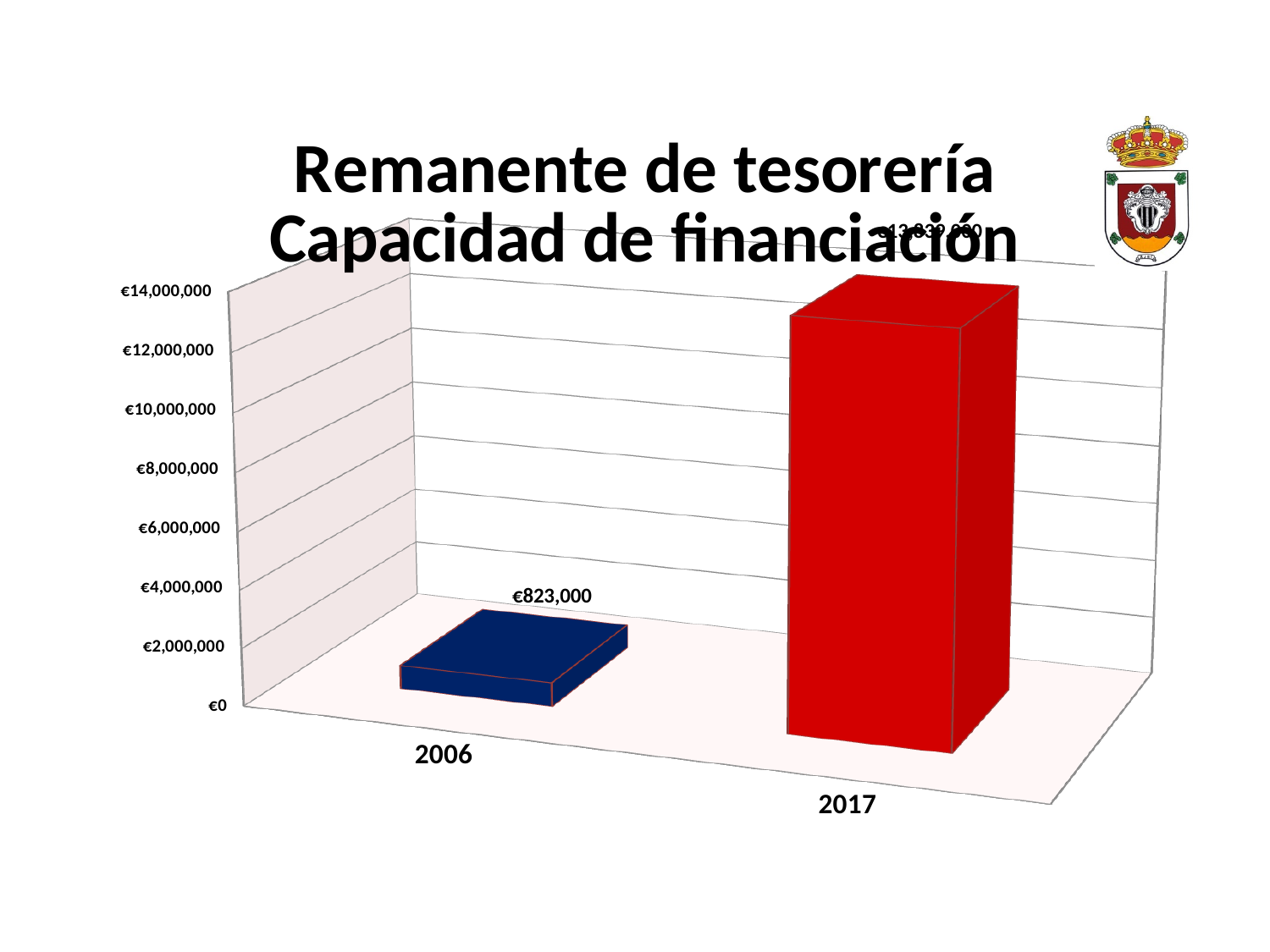
Is the value for 2017 greater or less than €10,000,000? greater Is the value for 2006 greater or less than €2,000,000? less Do the values rise or fall from 2006 to 2017? rise What is the value for 2006? €823,000 What is the title of the chart? Remanente de tesorería Capacidad de financiación Which year has the highest value? 2017 Which year has the lowest value? 2006 What kind of chart is shown on the slide? bar chart What colour is the bar for 2017? red How many years are shown on the chart? 2 Which is larger, the value for 2006 or the value for 2017? 2017